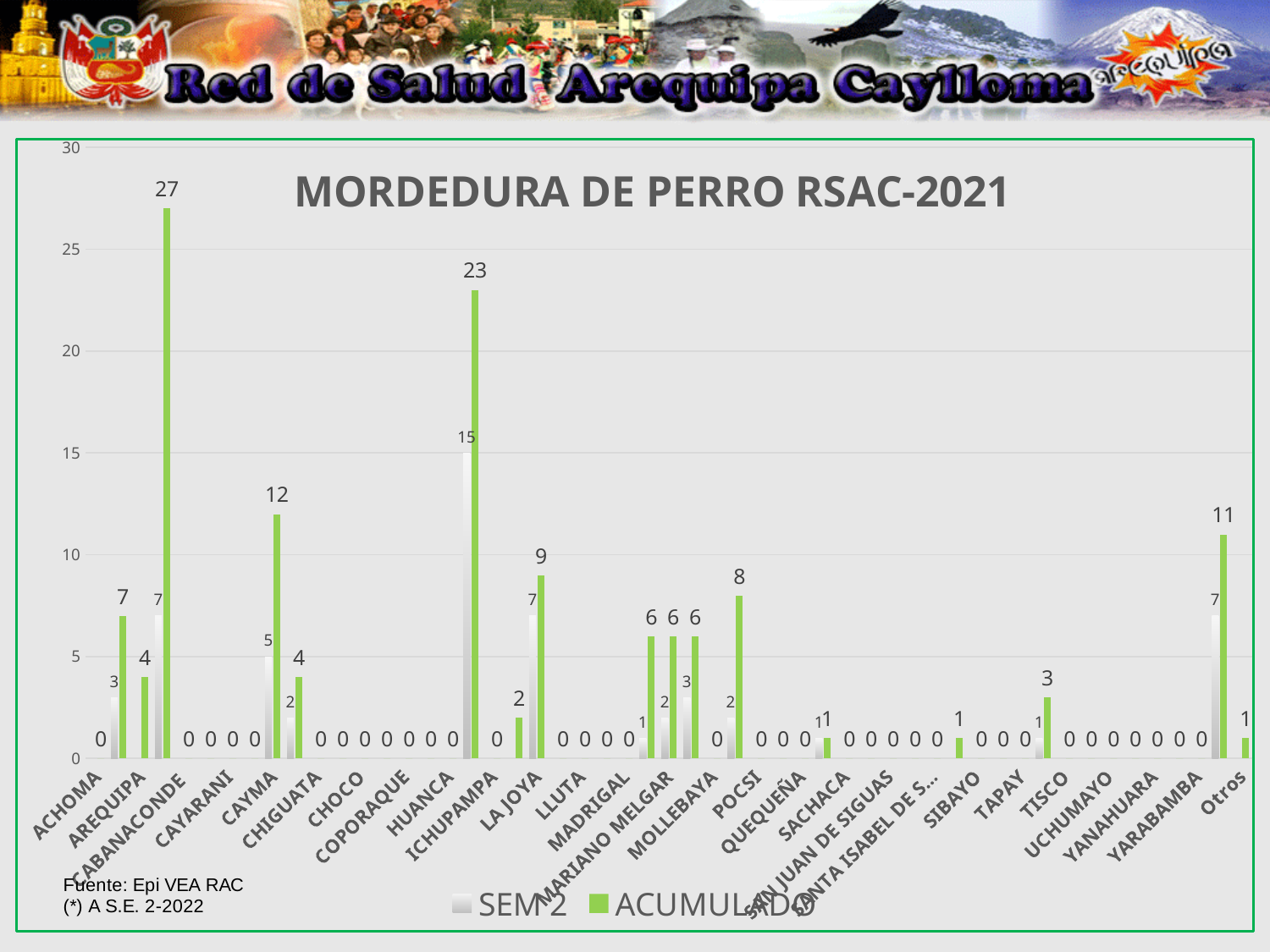
What value is labeled for ACHOMA? 0 What is the highest SEM 2 value labeled on the chart? 15 How many series does the legend list? 2 Is the tallest bar on the chart greater or less than 25? greater What is the ACUMULADO value for Otros? 1 What are the two series named in the legend? SEM 2 and ACUMULADO What is the difference between the two largest ACUMULADO values labeled (27 and 23)? 4 In the group where SEM 2 is 15, is the ACUMULADO value larger or smaller than the SEM 2 value? larger What is the second-highest ACUMULADO value labeled on the chart? 23 What is the highest ACUMULADO value labeled on the chart? 27 What type of chart is shown on the slide? bar chart What is the title of the chart? MORDEDURA DE PERRO RSAC-2021